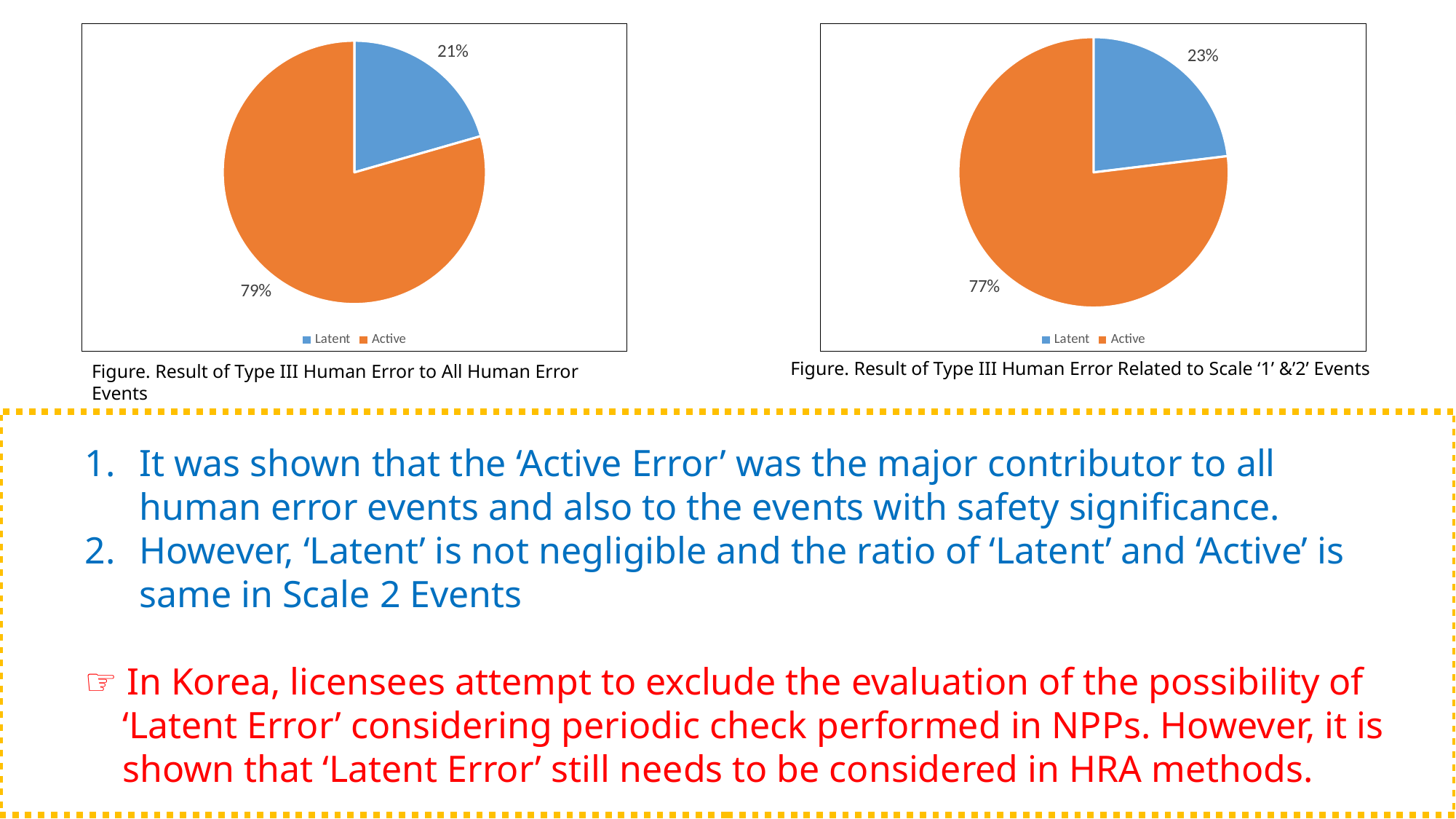
In the left pie chart, what colour is the Active slice? Orange In the left pie chart (Type III Human Error to All Human Error Events), what share is labelled for the Latent slice? 21% How many categories does the legend of the right pie chart list? 2 In the left pie chart, which category has the largest slice? Active In the left pie chart (Type III Human Error to All Human Error Events), what share is labelled for the Active slice? 79% In the right pie chart, which category has the smallest slice? Latent In the right pie chart (Type III Human Error Related to Scale '1' & '2' Events), what share is labelled for the Active slice? 77% What type of chart is shown on the left of the slide? Pie chart In the left pie chart, what is the difference between the Active and Latent shares? 58% In the right pie chart, what is the difference between the Active and Latent shares? 54% Which is larger: the Latent share in the left pie chart or the Latent share in the right pie chart? The right pie chart (23%)